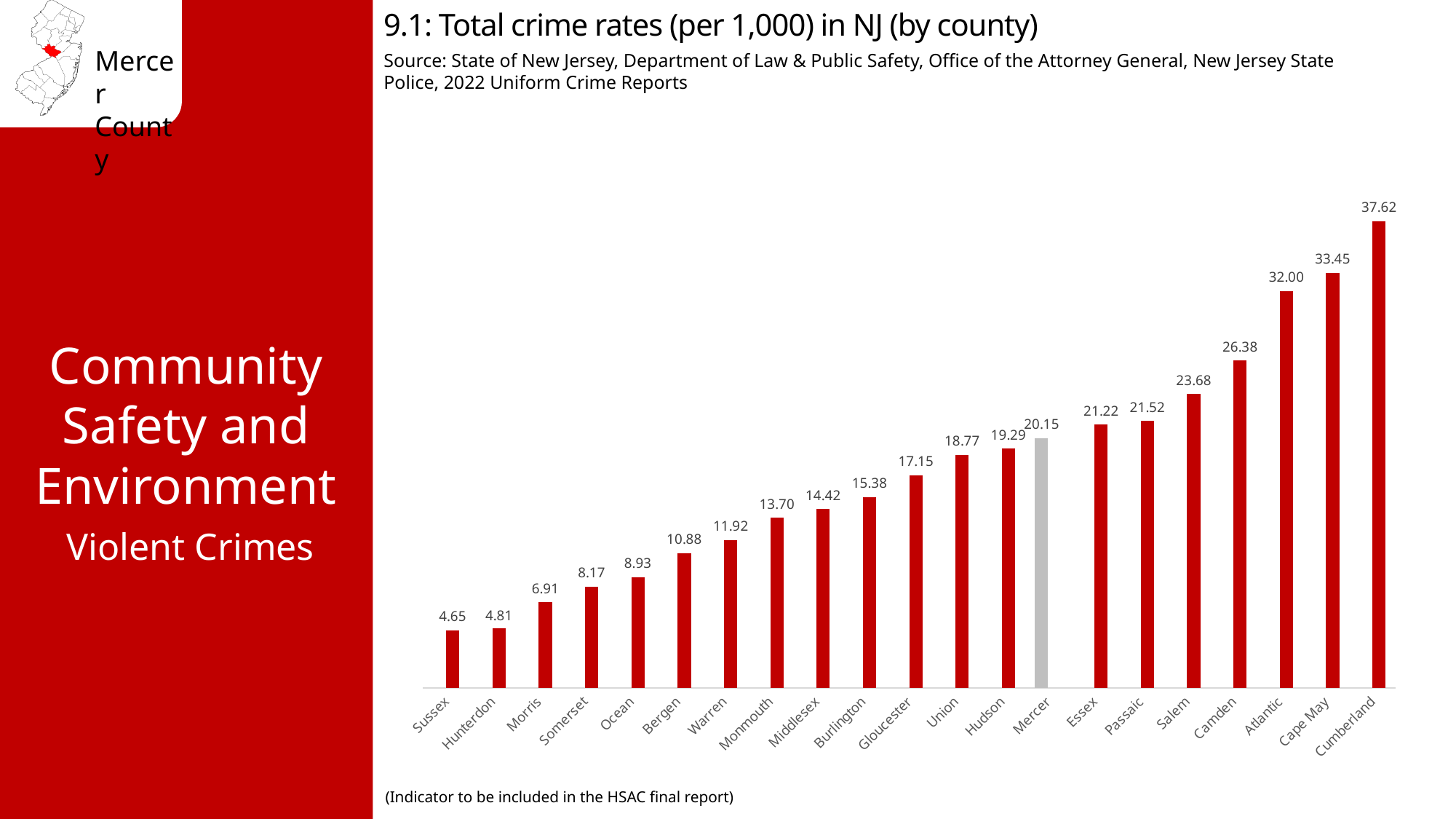
Which county has the lowest total crime rate? Sussex Which has a higher total crime rate, Essex or Union? Essex What is the total crime rate for Bergen County? 10.88 What is the difference between the crime rates of Mercer and Hudson? 0.86 Which county's bar is shown in grey rather than red? Mercer What is the total crime rate for Mercer County? 20.15 How many counties are shown in the chart? 21 Which has a higher total crime rate, Camden or Salem? Camden What is the total crime rate for Cumberland County? 37.62 What kind of chart is shown on the slide? Bar chart What is the difference between the crime rates of Cumberland and Sussex? 32.97 Which county has the highest total crime rate? Cumberland